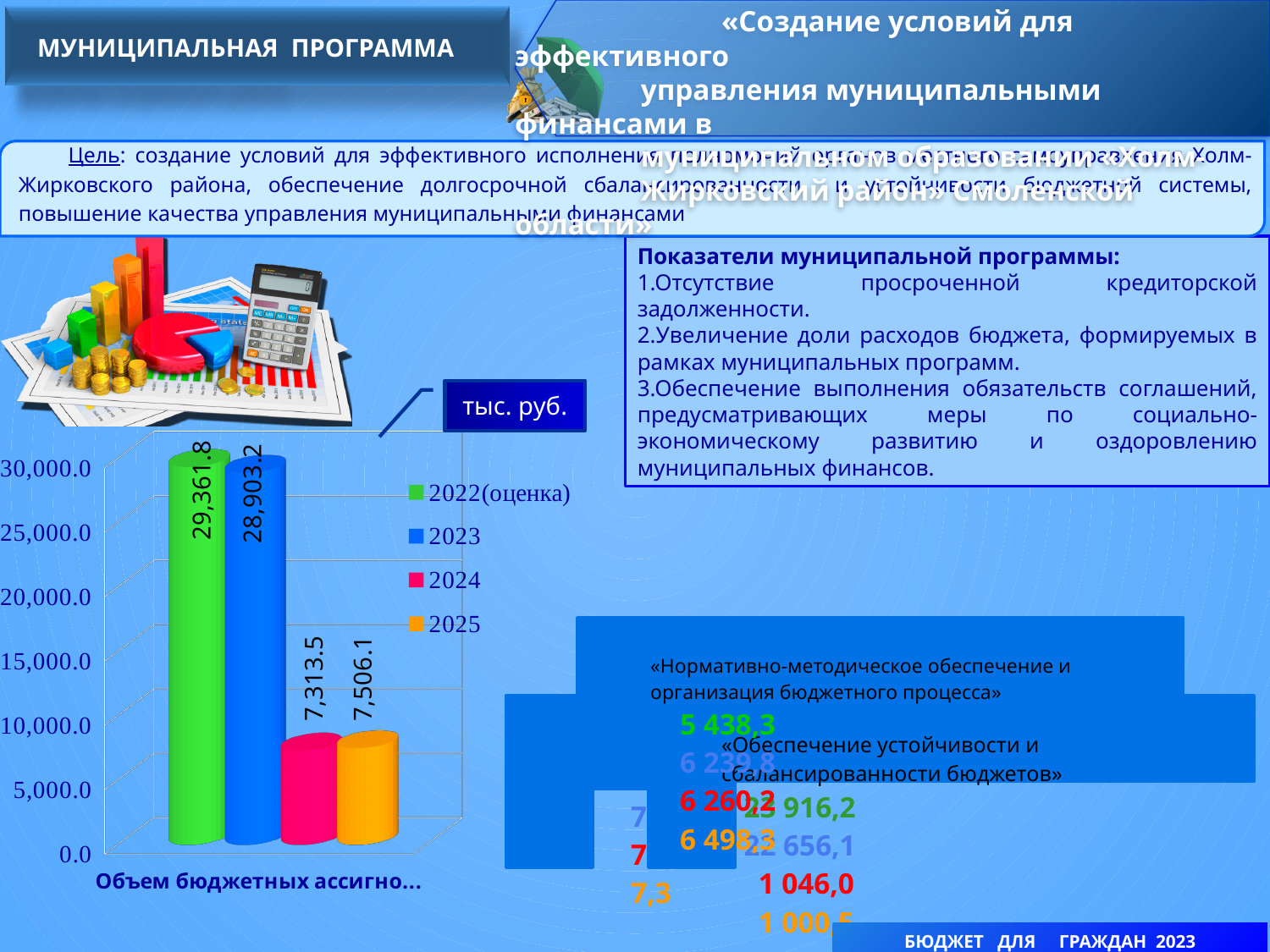
What kind of chart is shown on the slide? bar chart What unit is indicated for the values in the bar chart? тыс. руб. What is the difference between the values for 2022(оценка) and 2023 in the bar chart? 458.6 What is the value for 2022(оценка) in the bar chart? 29,361.8 What is the difference between the values for 2025 and 2024 in the bar chart? 192.6 Which series has the lowest value in the bar chart? 2024 What is the value for 2023 in the bar chart? 28,903.2 Which is larger in the bar chart, the value for 2023 or the value for 2025? 2023 Which series has the highest value in the bar chart? 2022(оценка) What is the value for 2025 in the bar chart? 7,506.1 What is the value for 2024 in the bar chart? 7,313.5 How many series does the legend of the bar chart list? 4